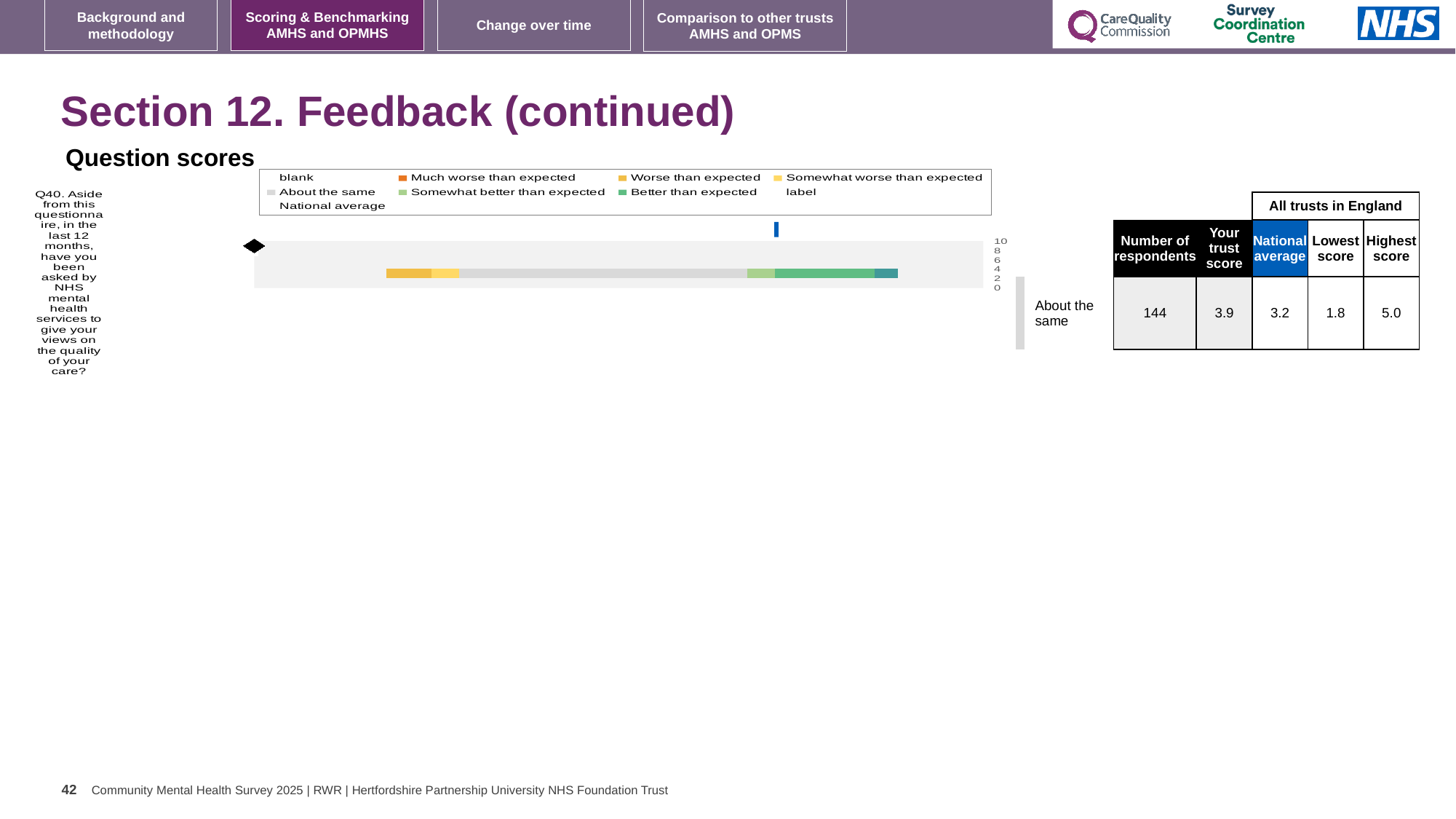
What rating category is shown next to the bar for Q40? About the same In the table beside the chart, what is the number of respondents for Q40? 144 Which question is plotted in the chart? Q40 What kind of chart is used to show the Q40 question score? bar chart In the table beside the chart, what is the highest score among all trusts in England for Q40? 5.0 In the table beside the chart, what is 'Your trust score' for Q40? 3.9 For Q40, what is the difference between the highest score and the lowest score among all trusts in England? 3.2 In the table beside the chart, what is the national average for Q40? 3.2 In the table beside the chart, what is the lowest score among all trusts in England for Q40? 1.8 For Q40, which is larger: the trust score or the national average? the trust score How many survey questions are plotted in the chart? 1 What colour does the legend use for 'Better than expected'? green